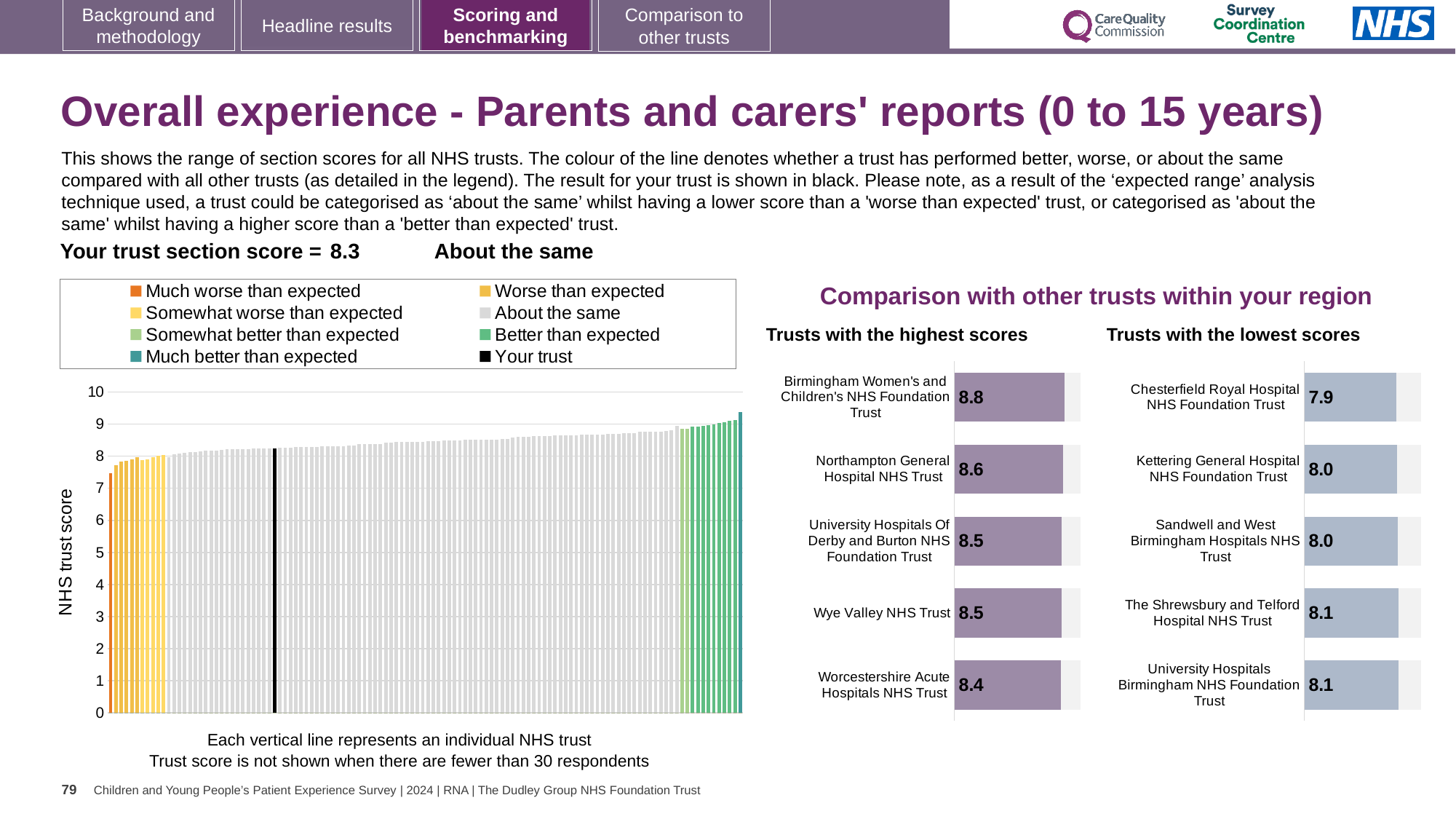
In the 'Trusts with the lowest scores' chart, which trust has the lowest score? Chesterfield Royal Hospital NHS Foundation Trust How many entries does the legend of the main NHS trust score chart list? 8 How many trusts are listed in the 'Trusts with the highest scores' chart? 5 In the 'Trusts with the highest scores' chart, which trust has the highest score? Birmingham Women's and Children's NHS Foundation Trust In the 'Trusts with the lowest scores' chart, what is the score for Chesterfield Royal Hospital NHS Foundation Trust? 7.9 In the 'Trusts with the highest scores' chart, what is the score for Birmingham Women's and Children's NHS Foundation Trust? 8.8 In the 'Trusts with the highest scores' chart, what is the difference between the scores of Birmingham Women's and Children's NHS Foundation Trust and Worcestershire Acute Hospitals NHS Trust? 0.4 Comparing the two right-hand charts, which has the higher score: Northampton General Hospital NHS Trust or Kettering General Hospital NHS Foundation Trust? Northampton General Hospital NHS Trust In the main NHS trust score chart, what is the section score for your trust (the black bar)? 8.3 In the 'Trusts with the lowest scores' chart, what is the difference between the scores of The Shrewsbury and Telford Hospital NHS Trust and Chesterfield Royal Hospital NHS Foundation Trust? 0.2 In the main NHS trust score chart, do the bar values rise or fall from left to right? rise What kind of chart is the main chart on the left showing NHS trust scores? bar chart